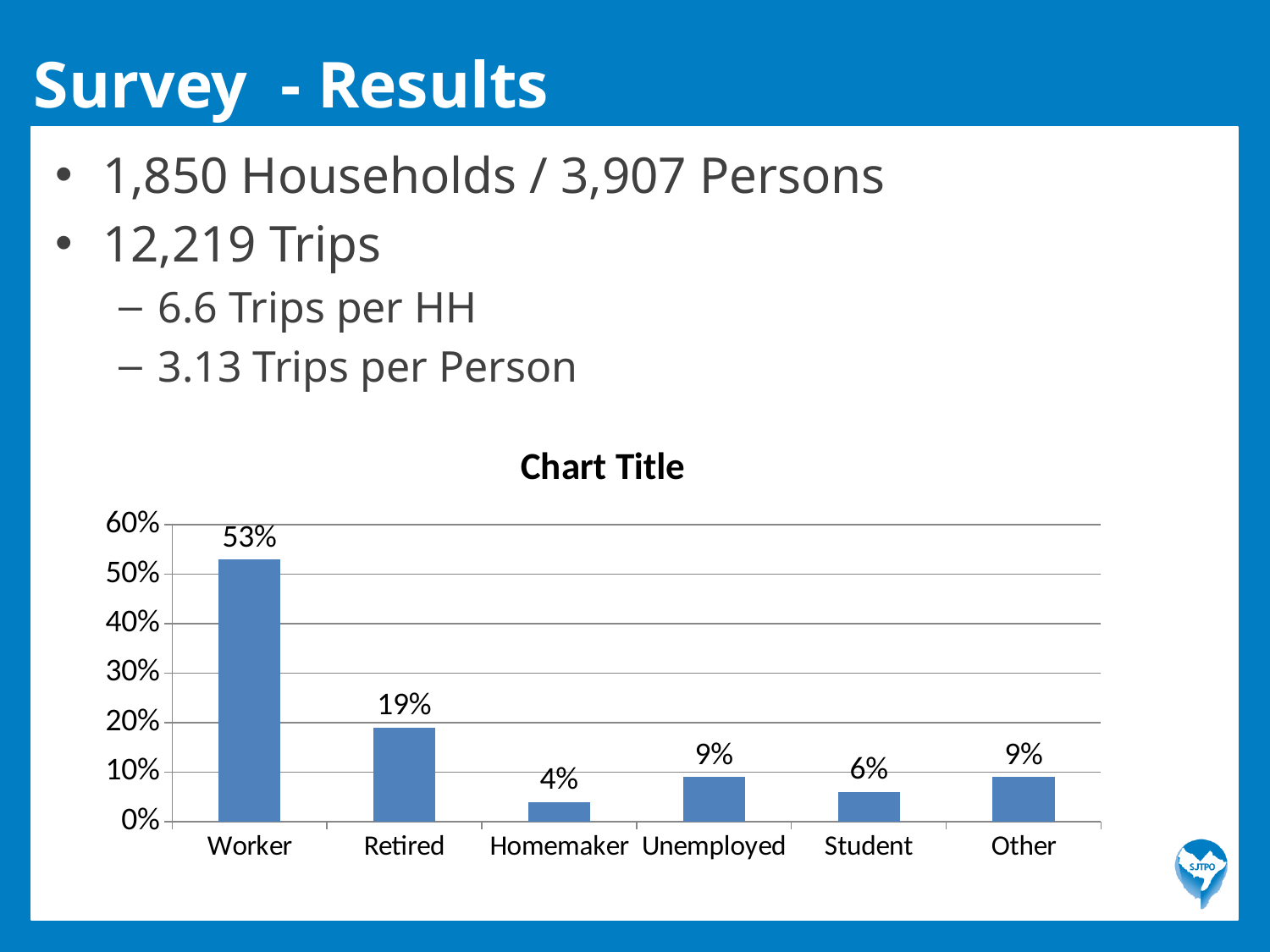
What is the difference between the values for Worker and Retired? 34% Which category has the highest value? Worker What is the value for Student? 6% Is the value for Worker greater or less than 50%? greater How many categories are shown on the x axis? 6 Which is larger, the value for Retired or the value for Unemployed? Retired What kind of chart is shown on the slide? bar chart What is the title of the chart? Chart Title Which category has the lowest value? Homemaker What is the value for Retired? 19% What is the value for Worker? 53% What is the value for Homemaker? 4%